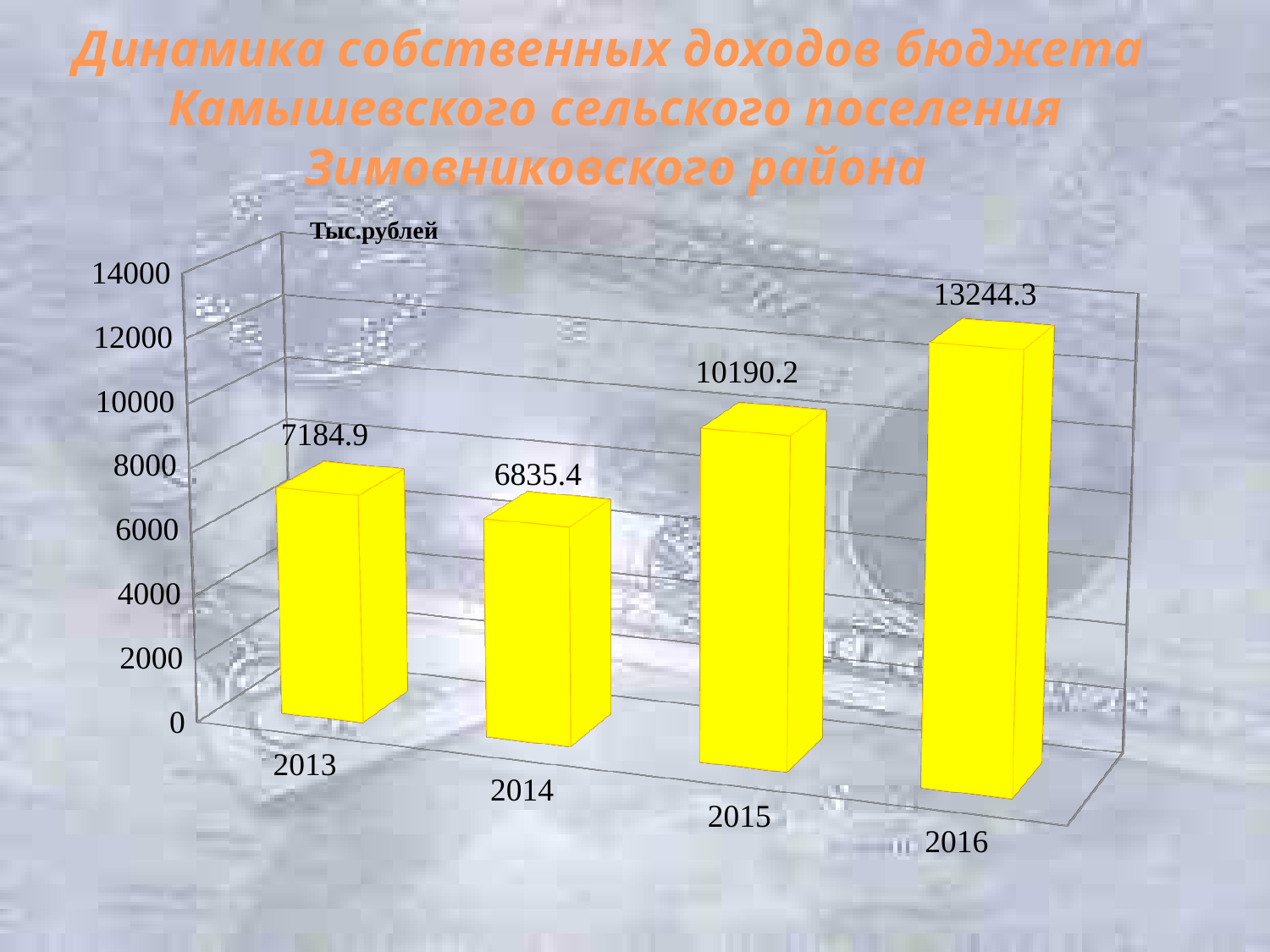
What is the value for 2016? 13244.3 What is the value for 2015? 10190.2 What is the value for 2014? 6835.4 Which year has the highest value? 2016 What is the difference between the values for 2013 and 2014? 349.5 What is the difference between the values for 2016 and 2015? 3054.1 Which year has the lowest value? 2014 What unit label is shown above the vertical axis? Тыс.рублей Which is larger, the value for 2013 or the value for 2014? 2013 What is the value for 2013? 7184.9 What kind of chart is shown on the slide? bar chart How many years are shown on the chart? 4